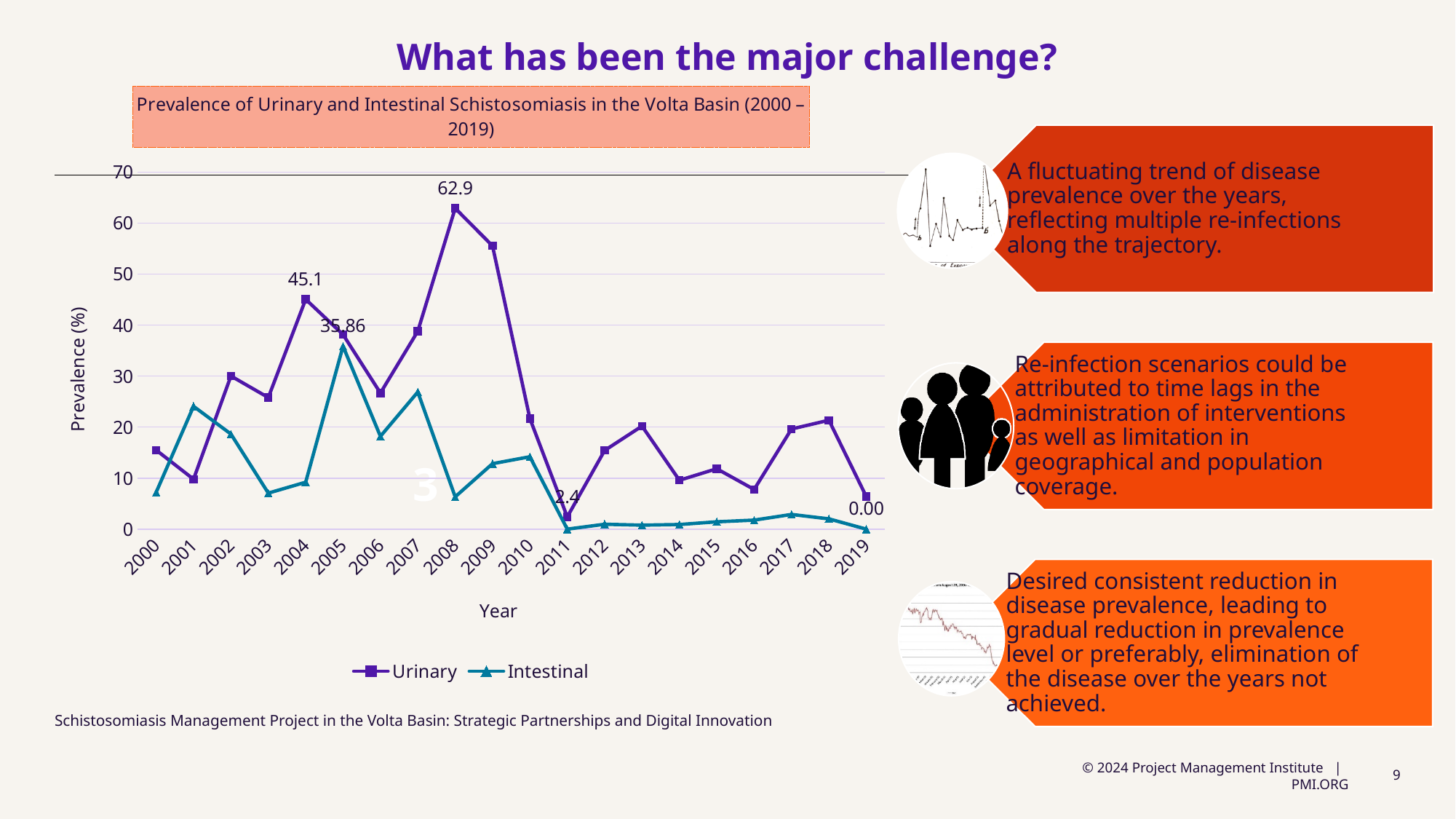
In which year does the Intestinal series reach its highest value? 2005 What is the Urinary prevalence value labelled for 2008? 62.9 In which year does the Urinary series reach its highest value? 2008 How many years are plotted along the x axis? 20 How many series does the chart legend list? 2 What is the difference between the Urinary values labelled for 2008 and 2004? 17.8 Is the Urinary value for 2009 greater or less than 50? greater What is the Intestinal prevalence value labelled for 2019? 0.00 What type of chart is shown on the slide? Line chart What is the Intestinal prevalence value labelled for 2005? 35.86 What is the Urinary prevalence value labelled for 2004? 45.1 What is the Urinary prevalence value labelled for 2011? 2.4